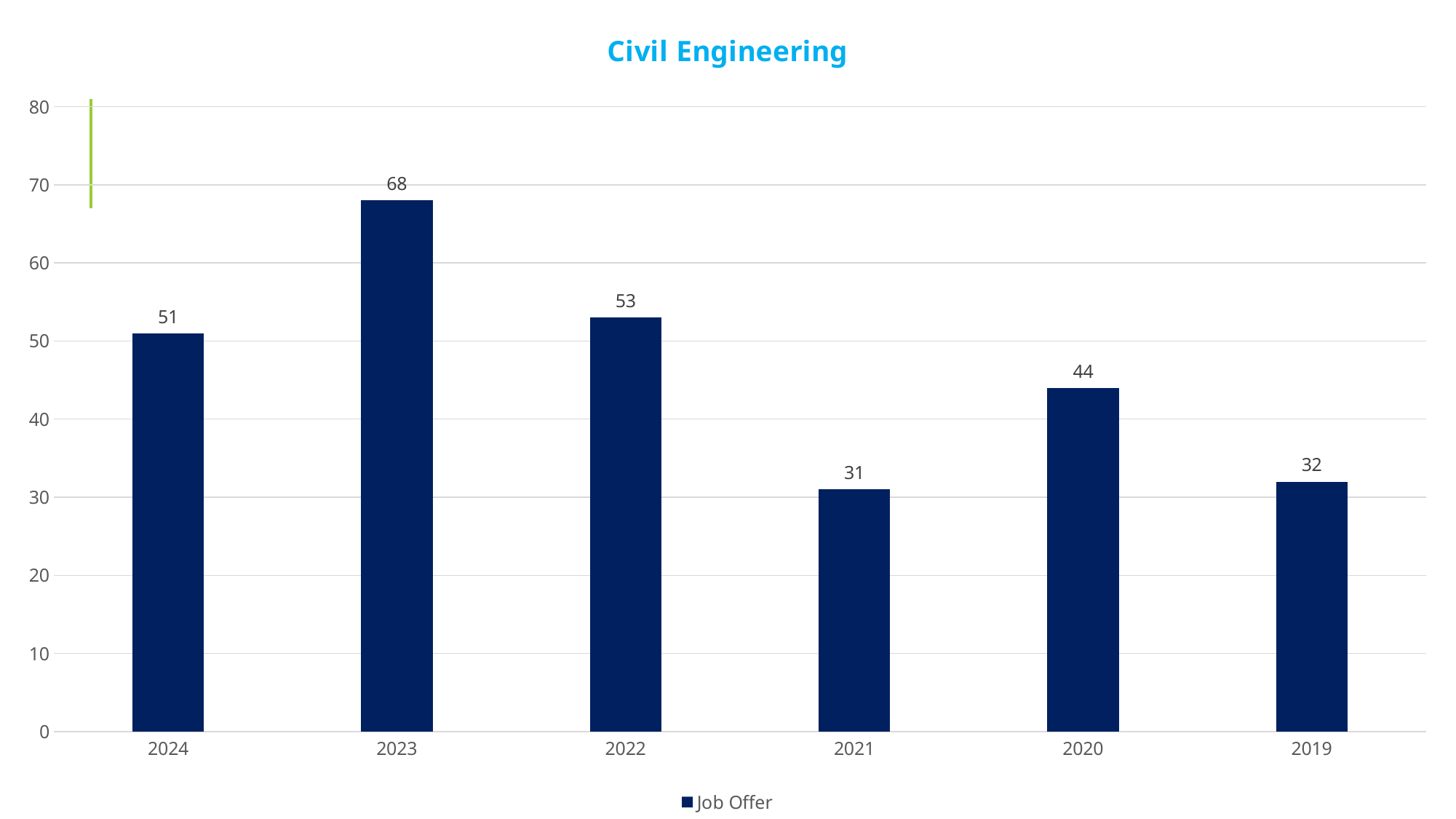
Which year has the highest Job Offer value? 2023 Which year has a larger Job Offer value, 2024 or 2020? 2024 What is the Job Offer value for 2021? 31 What is the difference between the Job Offer values for 2024 and 2020? 7 Which year has the lowest Job Offer value? 2021 What is the title of the chart? Civil Engineering What kind of chart is shown on the slide? bar chart Is the Job Offer value for 2022 greater or less than 50? greater What is the difference between the Job Offer values for 2023 and 2022? 15 What is the Job Offer value for 2023? 68 What is the Job Offer value for 2019? 32 How many years are shown on the x axis? 6